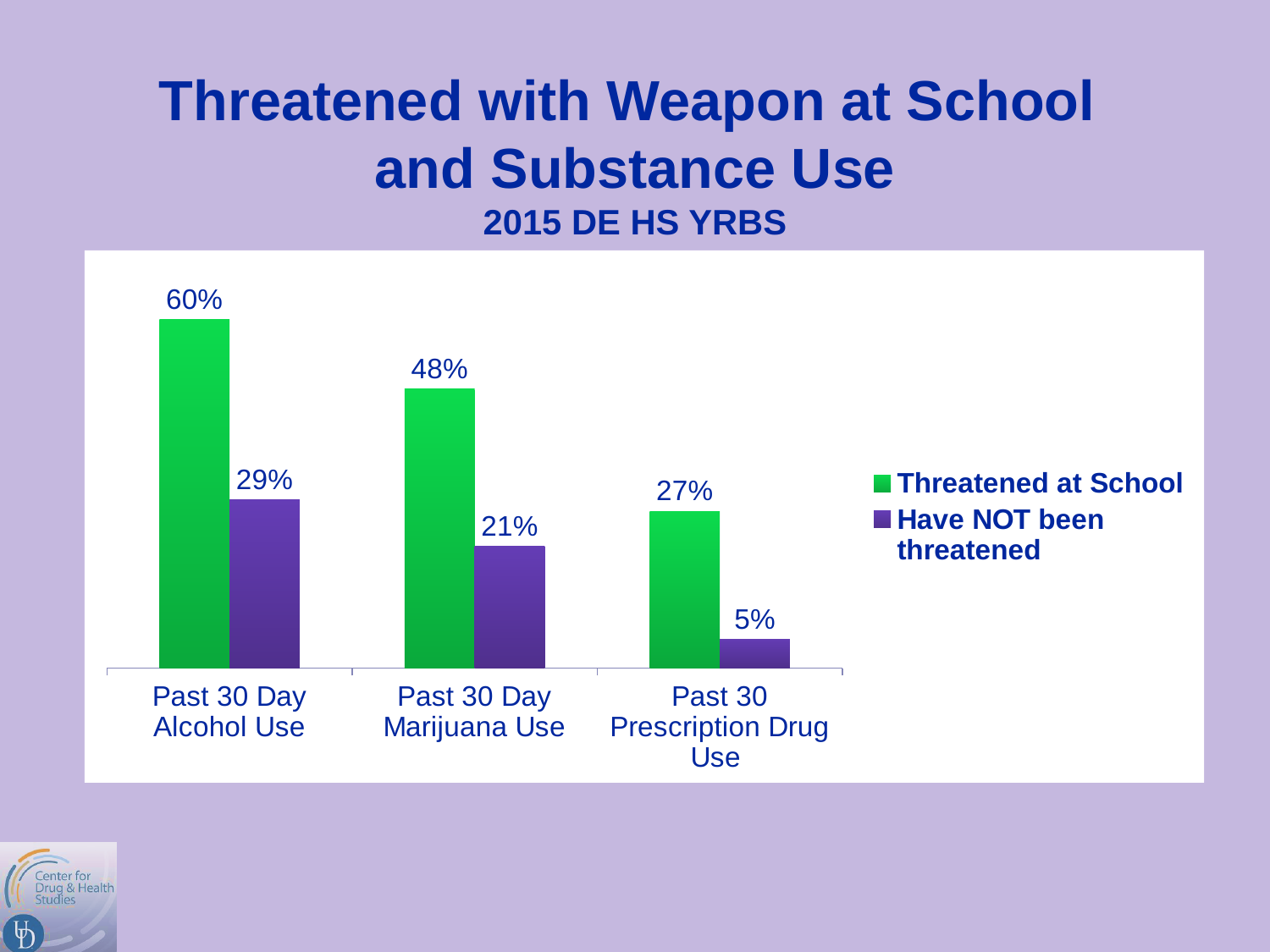
What is the value for 'Threatened at School' for Past 30 Prescription Drug Use? 27% What is the value for 'Have NOT been threatened' for Past 30 Prescription Drug Use? 5% Which category has the highest value for the 'Threatened at School' series? Past 30 Day Alcohol Use For Past 30 Day Marijuana Use, which series has the larger value? Threatened at School How many categories are shown on the x axis? 3 What is the value for 'Have NOT been threatened' for Past 30 Day Marijuana Use? 21% What kind of chart is shown on the slide? Bar chart What is the difference between the 'Threatened at School' and 'Have NOT been threatened' values for Past 30 Prescription Drug Use? 22% Which category has the lowest value for the 'Have NOT been threatened' series? Past 30 Prescription Drug Use How many series does the legend list? 2 What is the difference between the 'Threatened at School' and 'Have NOT been threatened' values for Past 30 Day Alcohol Use? 31% What percentage of students who were threatened at school reported past 30 day alcohol use? 60%